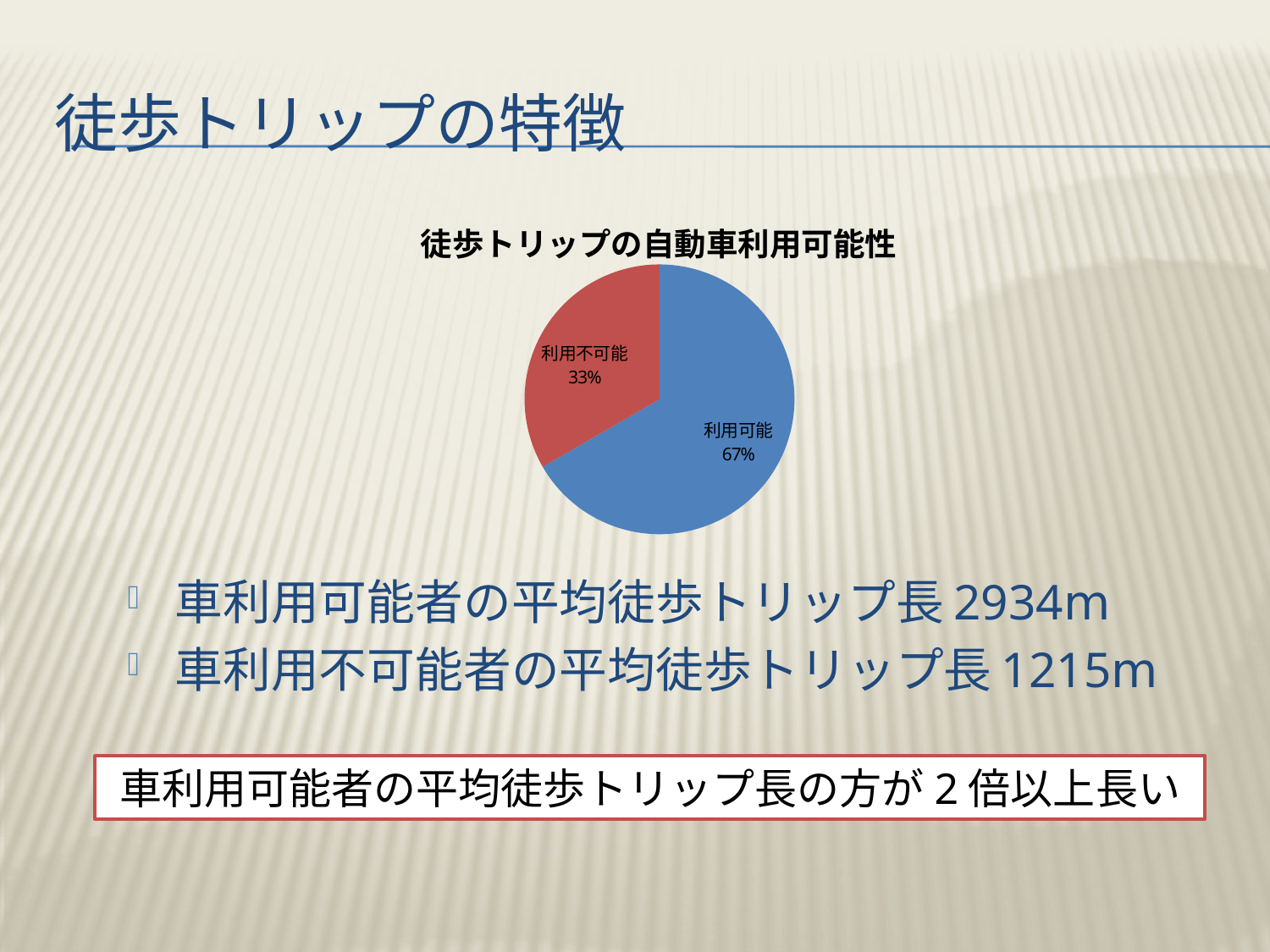
What is the difference in percentage points between the 利用可能 and 利用不可能 slices? 34 What type of chart is shown on the slide? pie chart What colour is the 利用不可能 slice? red How many slices does the pie chart have? 2 Which is larger, the 利用可能 slice or the 利用不可能 slice? 利用可能 Which slice of the pie is the largest? 利用可能 What percentage of the pie is labelled 利用可能? 67% Which slice of the pie is the smallest? 利用不可能 What share of the pie does the 利用可能 slice represent? 67% What is the title of the chart? 徒歩トリップの自動車利用可能性 What percentage of the pie is labelled 利用不可能? 33%